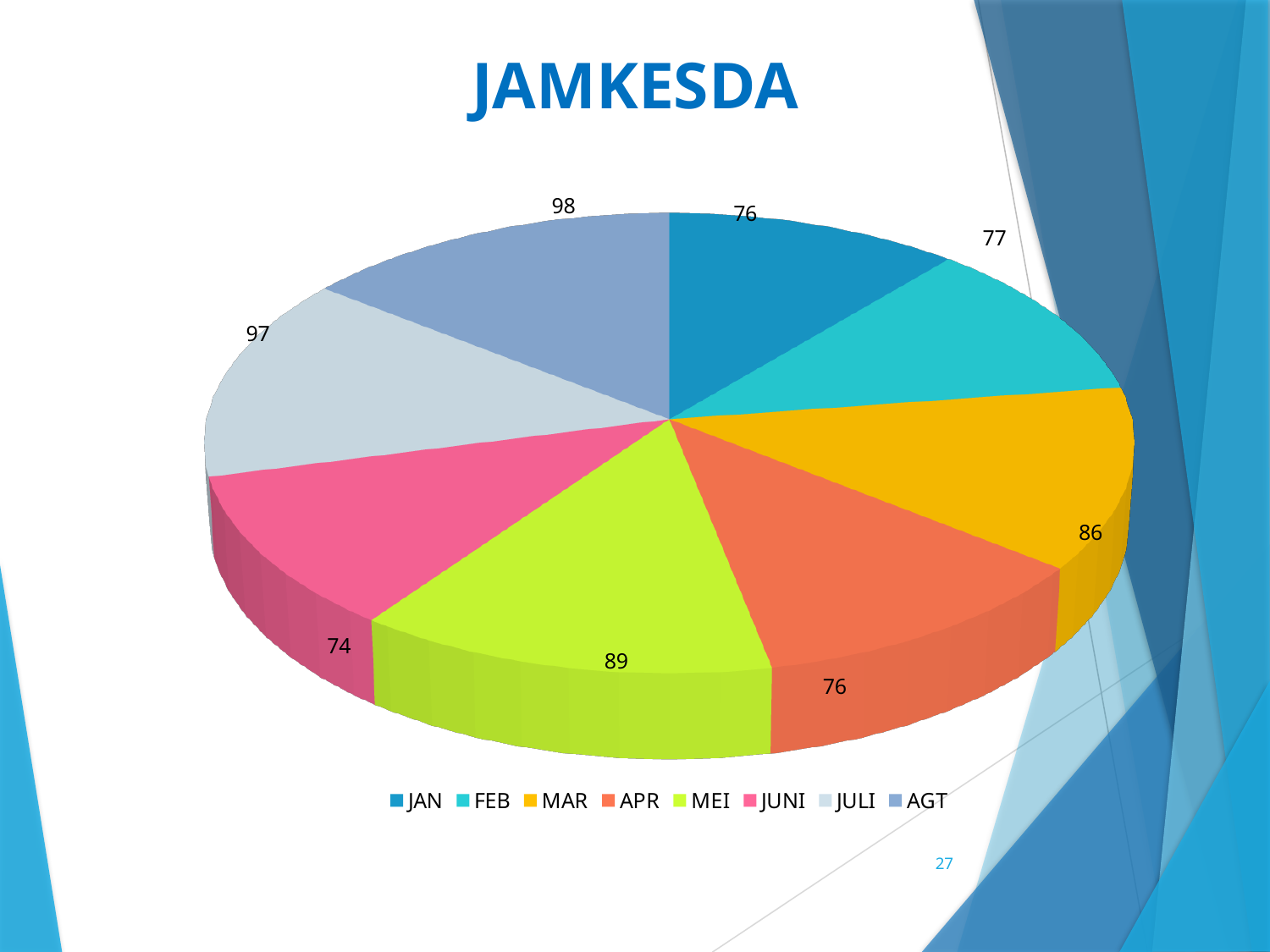
How many slices does the pie chart have? 8 What type of chart is shown on the slide? pie chart What is the title of the chart? JAMKESDA What is the value for MAR? 86 What is the value for JUNI? 74 What is the difference between the values for AGT and JUNI? 24 What is the value for AGT? 98 Which month has the lowest value? JUNI Which is larger, the value for MAR or the value for FEB? MAR Which month has the highest value? AGT What is the value for MEI? 89 Which legend entry is shown in yellow-green? MEI